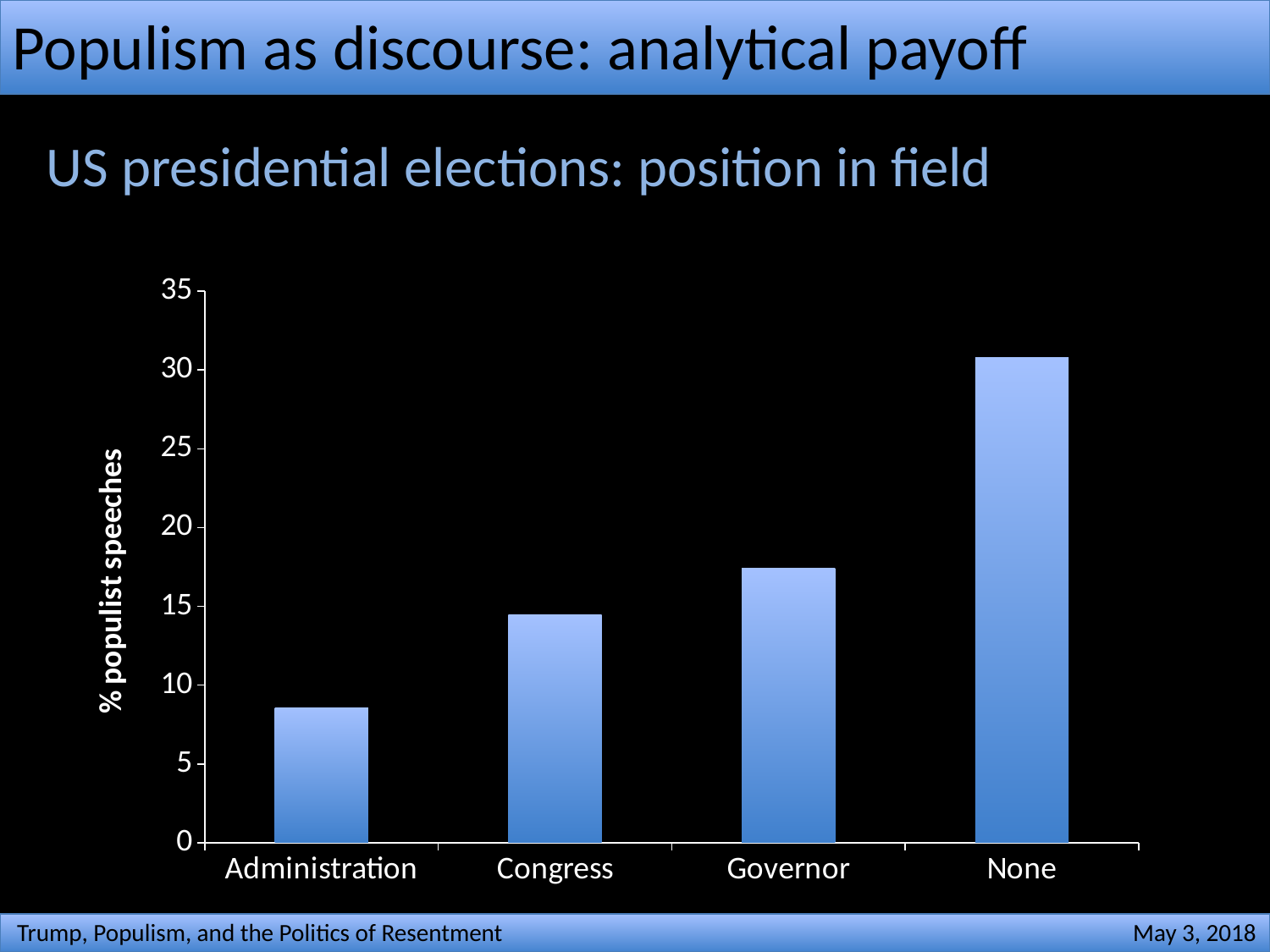
Is the value for Governor greater or less than 15? greater Is the value for None greater or less than 30? greater Is the value for Administration greater or less than 10? less Which has a higher value, Administration or None? None What is the label on the vertical axis of the chart? % populist speeches How many categories are shown on the x axis of the chart? 4 Which category has the lowest percentage of populist speeches? Administration What kind of chart is shown on the slide? bar chart Which category has the highest percentage of populist speeches? None Do the bar values rise or fall moving from Administration to None along the x axis? rise Which has a higher value, Congress or Governor? Governor